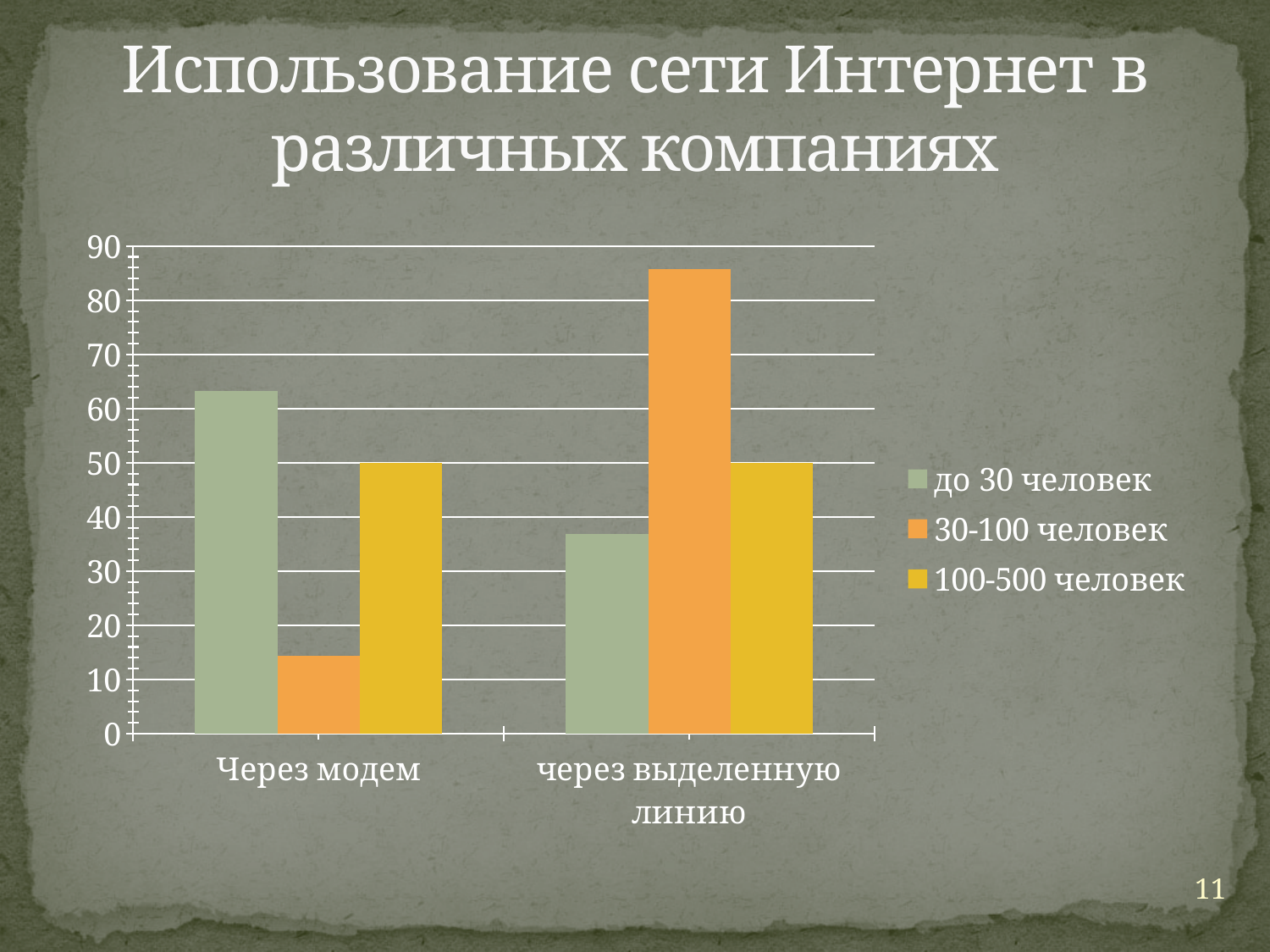
Which series has the lowest value in the 'через выделенную линию' category? до 30 человек For the '30-100 человек' series, which category has the larger value: 'Через модем' or 'через выделенную линию'? через выделенную линию Which series is shown in orange in the legend? 30-100 человек Which series has the highest value in the 'Через модем' category? до 30 человек Is the value for 'до 30 человек' in the 'через выделенную линию' category greater or less than 40? less Is the value for '30-100 человек' in the 'Через модем' category greater or less than 20? less What is the title of the slide? Использование сети Интернет в различных компаниях What kind of chart is shown on the slide? bar chart How many categories are shown on the x axis? 2 Is the value for 'до 30 человек' in the 'Через модем' category greater or less than 60? greater How many series does the legend list? 3